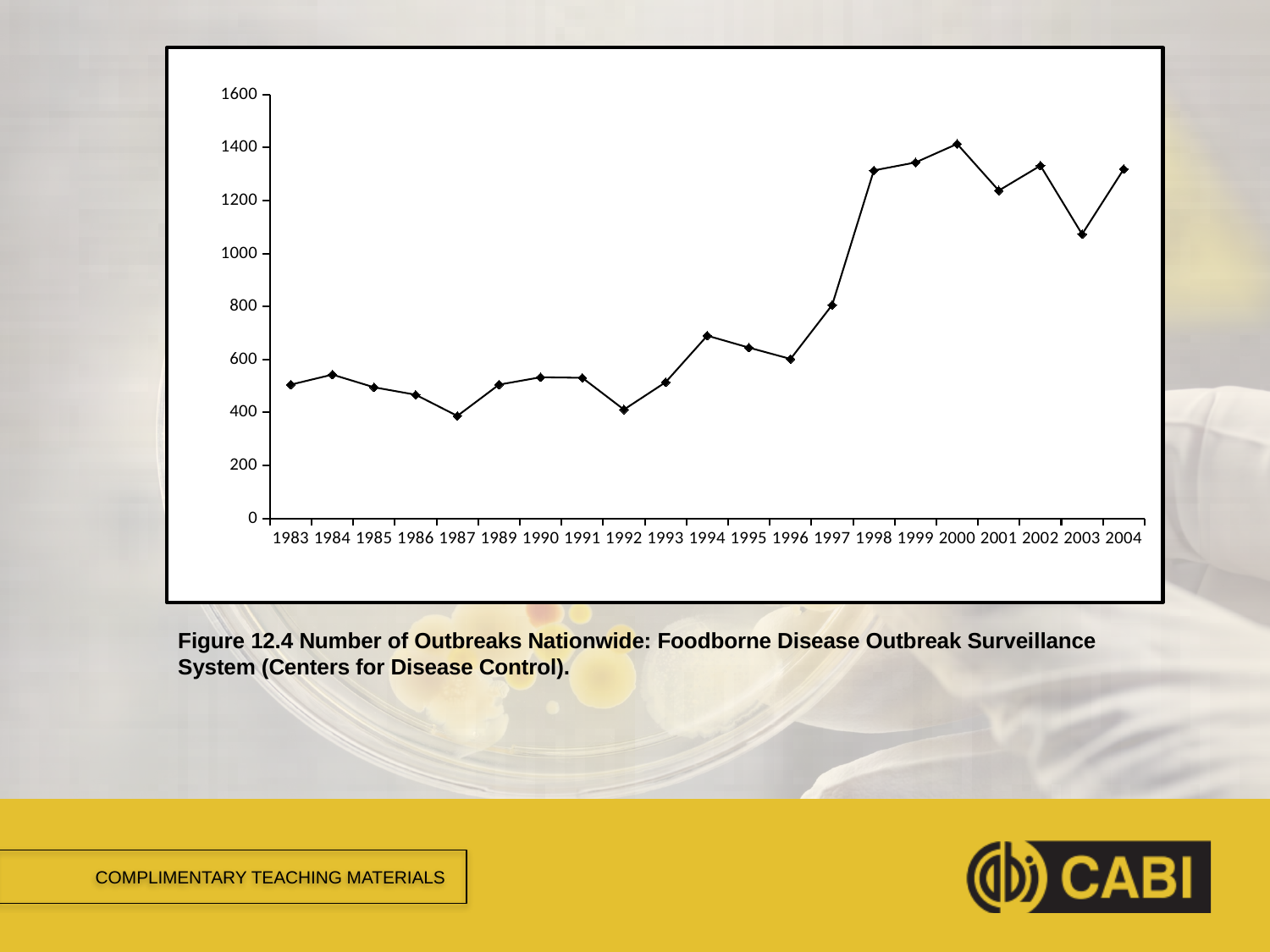
Is the value for 1994 greater or less than 600? greater How many years are plotted along the x axis? 21 Which year has the larger value, 2001 or 2003? 2001 What kind of chart is shown on the slide? line chart Is the value for 1983 greater or less than 600? less Which year has the highest number of outbreaks? 2000 Is the value for 1992 greater or less than 600? less What is the highest value shown on the y axis? 1600 Which year has the larger value, 1997 or 1998? 1998 Overall, do the values rise or fall from 1983 to 2004? rise